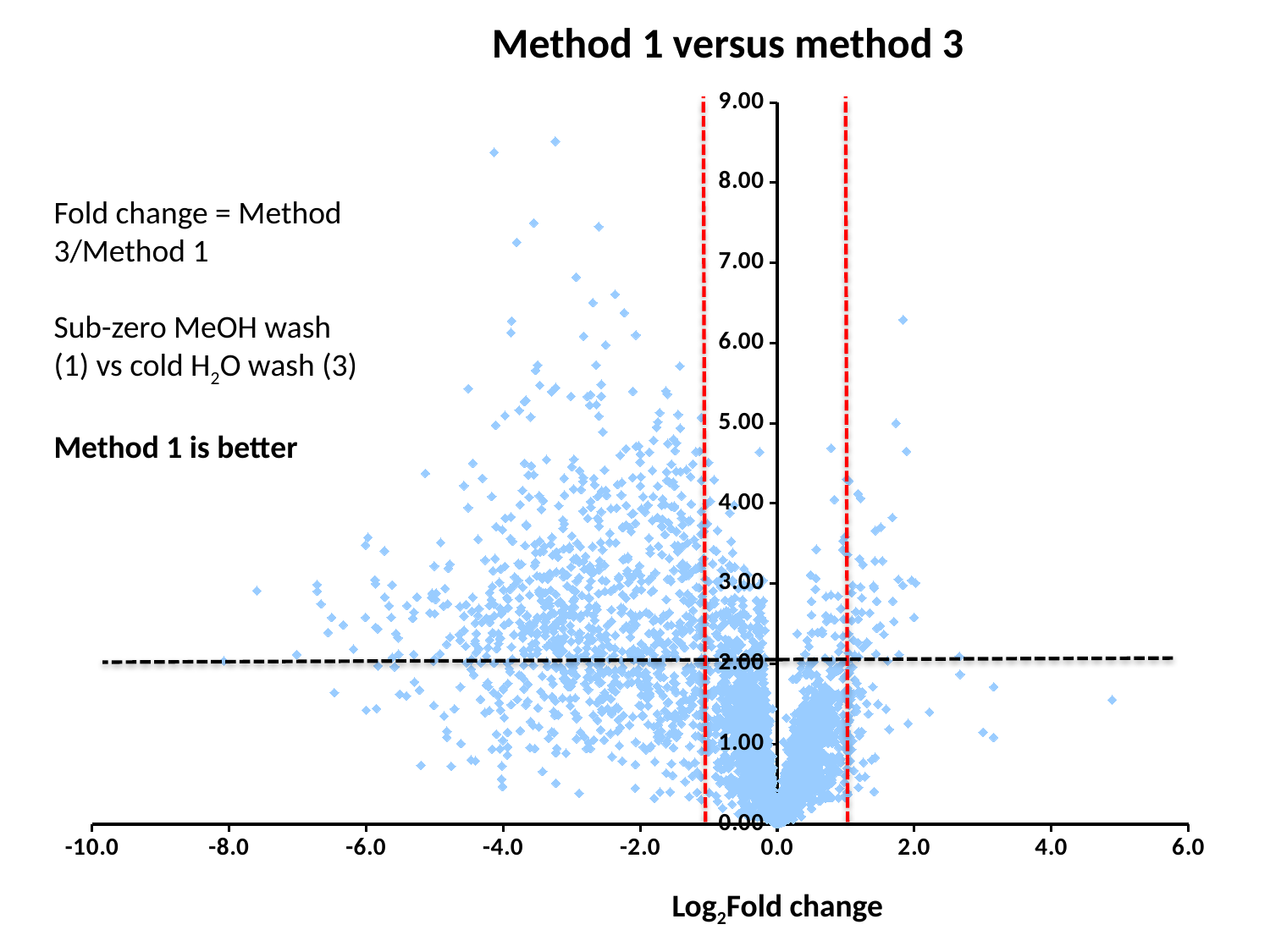
What is the highest value shown on the y axis of the chart? 9.00 What is the title of the chart? Method 1 versus method 3 What is the label of the x axis of the chart? Log2Fold change Is the leftmost data point on the chart at an x value greater or less than -6.0? Less Is the highest data point on the chart above or below 8.00 on the y axis? Above What kind of chart is shown on the slide? Scatter plot Are there more data points to the left of 0.0 or to the right of 0.0 on the x axis? Left of 0.0